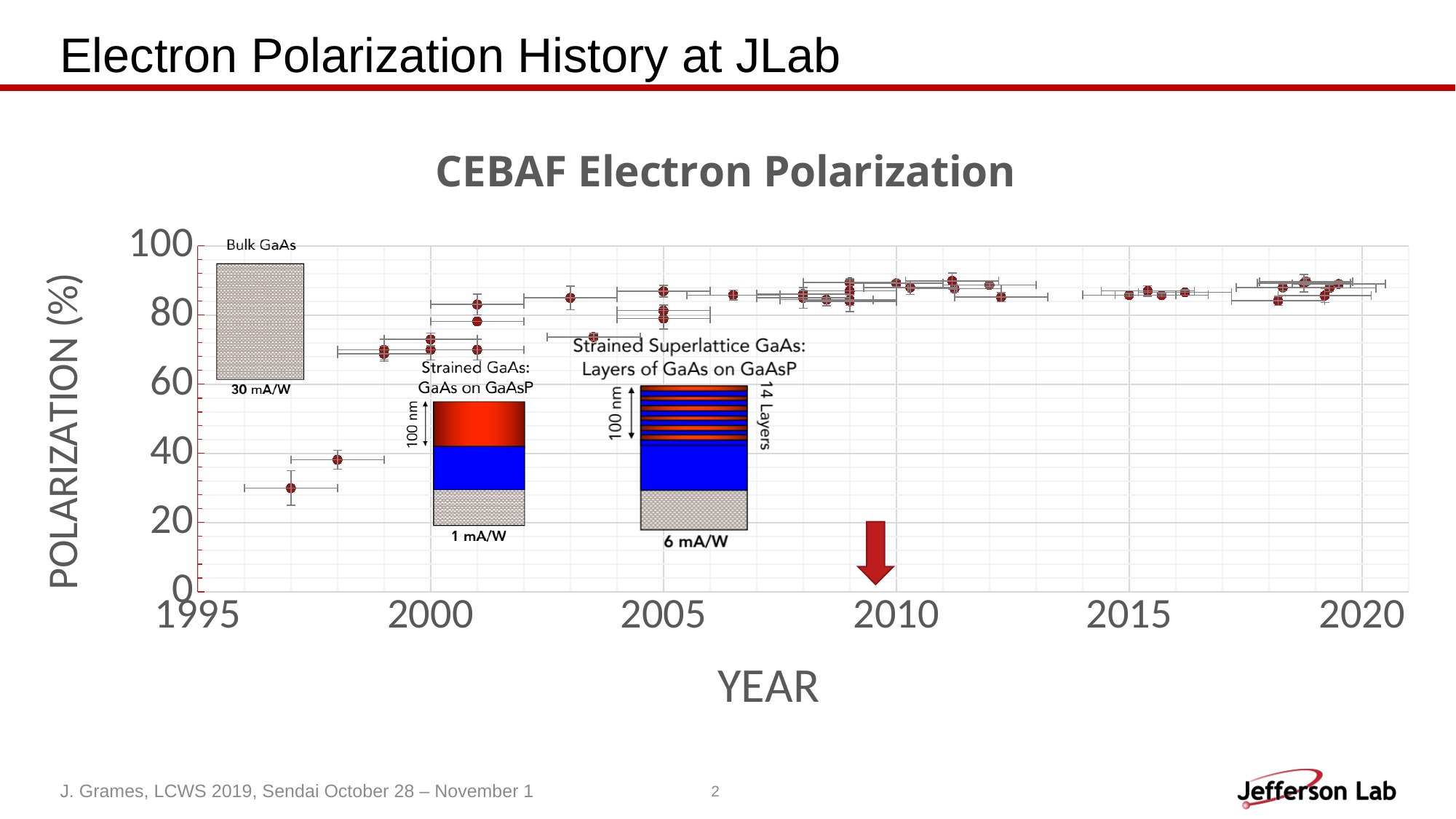
Is the polarization value for the earliest data point (around 1997) greater or less than 40? less Around which year does the lowest polarization data point occur? 1997 What is the label of the vertical axis of the chart? POLARIZATION (%) Overall, do the polarization values rise or fall as the year increases along the x axis? Rise What is the highest value shown on the vertical axis of the chart? 100 What kind of chart is shown on the slide? Scatter chart Are the polarization values for the data points around 2019 greater or less than 80? greater Is the polarization value for the data point around 1998 greater or less than 60? less Which has the higher polarization: the data point around 1997 or the data point around 2003? The data point around 2003 What is the title of the chart? CEBAF Electron Polarization